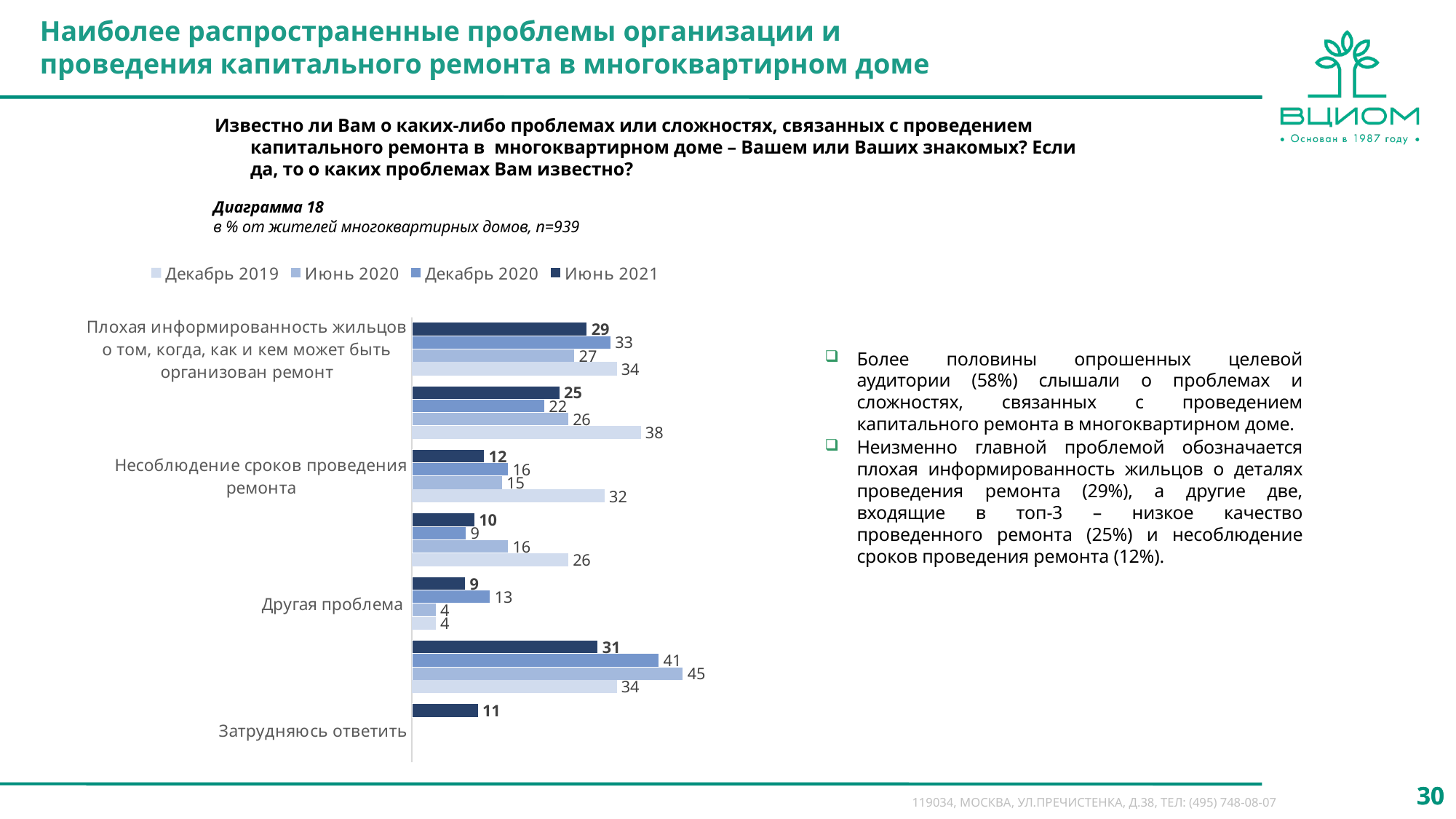
What is the Декабрь 2019 value for «Несоблюдение сроков проведения ремонта»? 32 What is the Июнь 2020 value for «Другая проблема»? 4 What is the Декабрь 2020 value for «Другая проблема»? 13 What is the difference between the Декабрь 2019 and Июнь 2021 values for «Плохая информированность жильцов о том, когда, как и кем может быть организован ремонт»? 5 What is the Июнь 2021 value for «Плохая информированность жильцов о том, когда, как и кем может быть организован ремонт»? 29 What is the Июнь 2020 value for «Несоблюдение сроков проведения ремонта»? 15 For «Плохая информированность жильцов о том, когда, как и кем может быть организован ремонт», which survey wave has the highest value? Декабрь 2019 For «Несоблюдение сроков проведения ремонта», which is larger: the Июнь 2021 value or the Декабрь 2019 value? Декабрь 2019 What kind of chart is shown on the slide? Bar chart What is the Июнь 2021 value for «Затрудняюсь ответить»? 11 How many series does the legend list? 4 Which series is listed first in the legend? Декабрь 2019